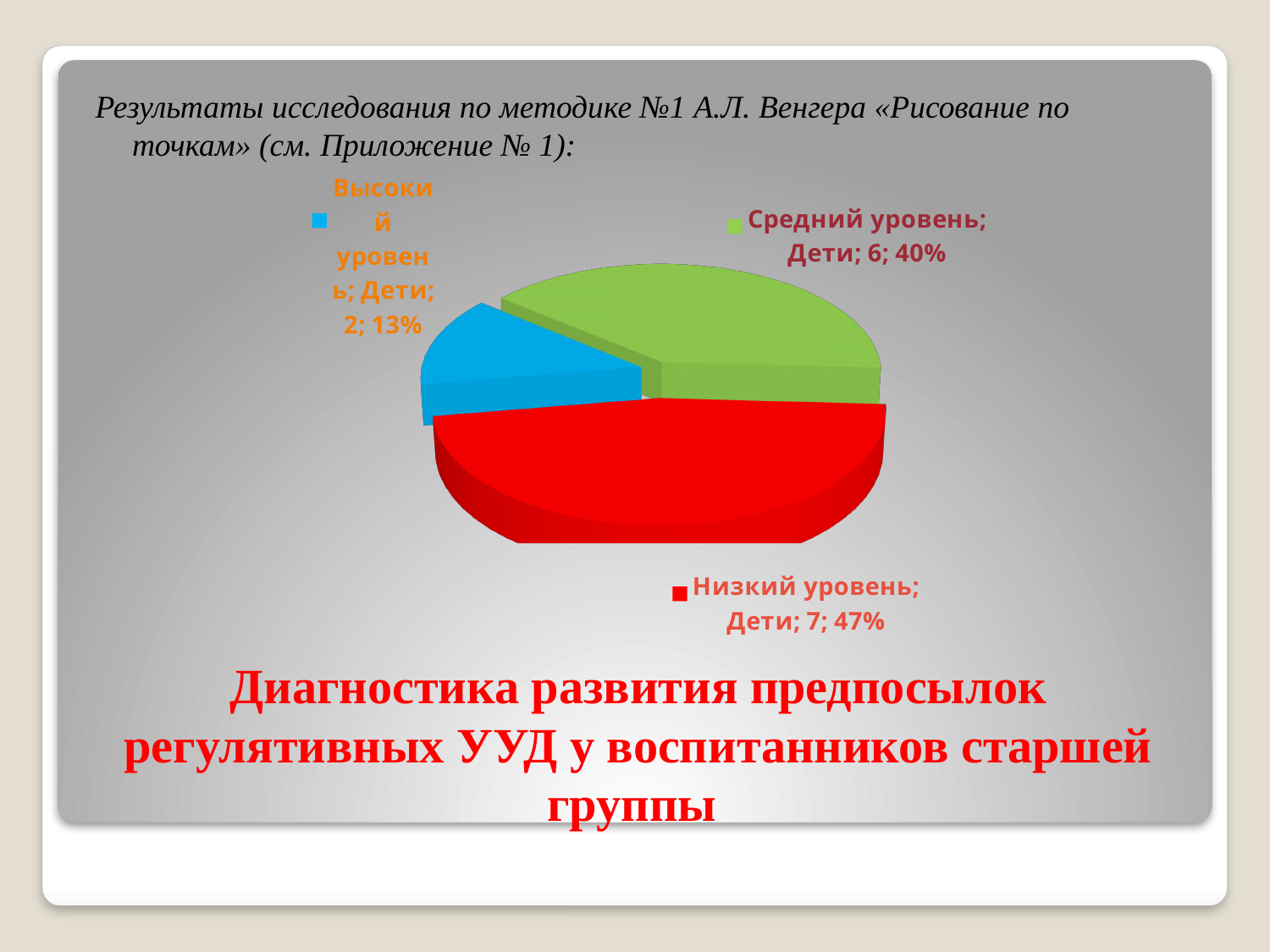
What share of the pie does "Низкий уровень" represent? 47% What share of the pie does "Высокий уровень" represent? 13% What colour is the slice for "Средний уровень"? Green How many children are in the "Средний уровень" category? 6 How many children are in the "Высокий уровень" category? 2 How many slices does the pie chart have? 3 How many children are in the "Низкий уровень" category? 7 Which category has the smallest slice of the pie? Высокий уровень Which category has the largest slice of the pie? Низкий уровень What kind of chart is shown on the slide? Pie chart What is the difference in the number of children between "Низкий уровень" and "Высокий уровень"? 5 Which category has more children, "Средний уровень" or "Высокий уровень"? Средний уровень